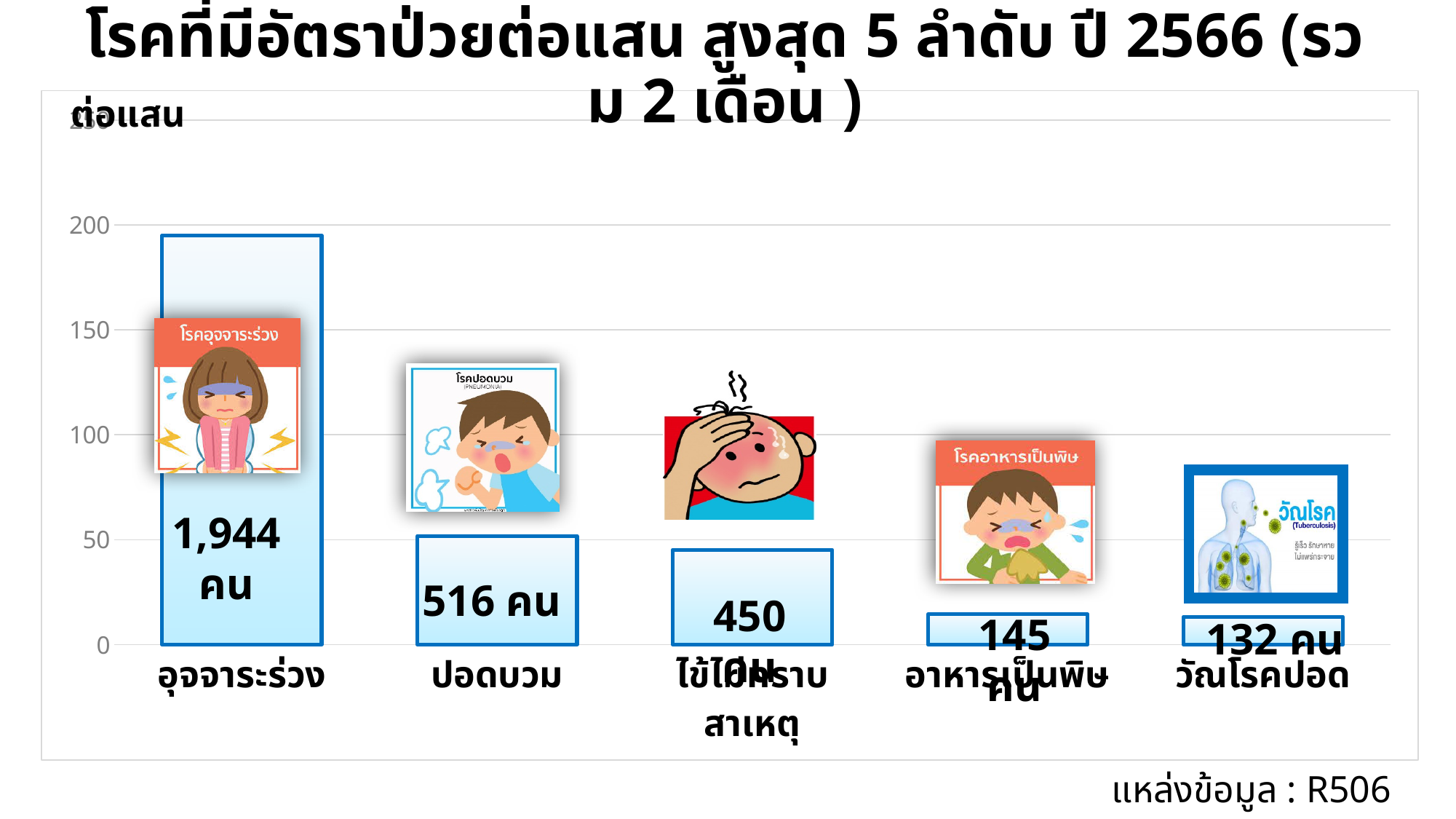
What is the value shown for อุจจาระร่วง? 1,944 คน Which disease has the lowest value in the chart? วัณโรคปอด What is the value shown for ปอดบวม? 516 คน How many diseases are shown in the chart? 5 Which is larger, the value for อาหารเป็นพิษ or the value for วัณโรคปอด? อาหารเป็นพิษ What is the difference between the values for ปอดบวม and ไข้ไม่ทราบสาเหตุ? 66 คน Which disease has the highest value in the chart? อุจจาระร่วง What is the value shown for อาหารเป็นพิษ? 145 คน Is the bar for อุจจาระร่วง greater or less than 150 on the axis? greater What kind of chart is shown on the slide? bar chart What data source is cited at the bottom of the slide? R506 What is the value shown for วัณโรคปอด? 132 คน